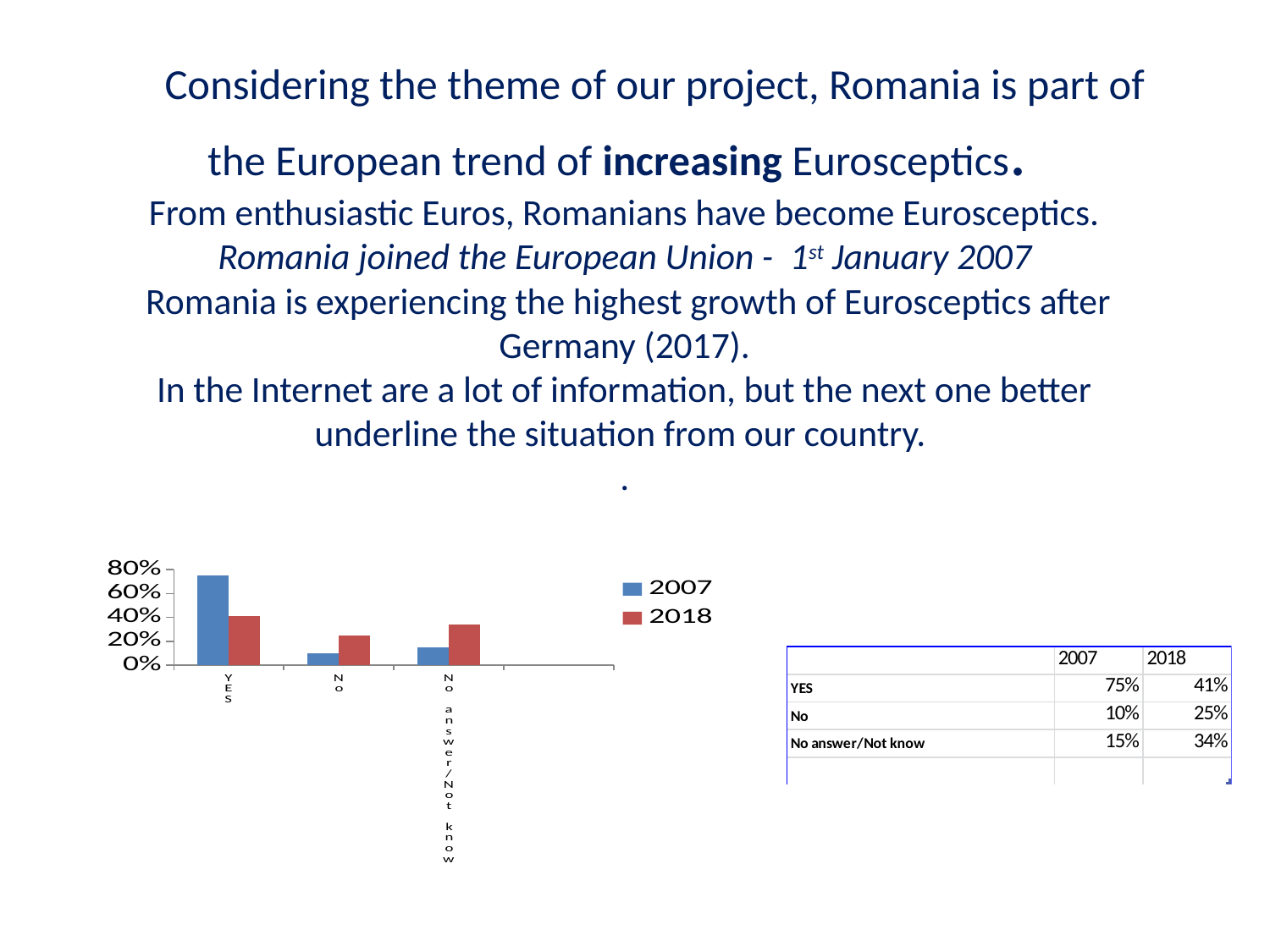
According to the table beside the chart, what is the value for No answer/Not know in 2018? 34% How many categories are shown on the x axis of the chart? 3 Using the values in the table, what is the difference between the 2007 and 2018 values for YES? 34% Which is larger for the No category: the 2007 value or the 2018 value? 2018 Is the 2007 value for YES greater or less than 60%? greater Which years are listed in the chart legend? 2007 and 2018 Which category has the lowest value for the 2007 series? No Which category has the highest value for the 2007 series? YES What kind of chart is shown on the slide? bar chart According to the table beside the chart, what is the value for YES in 2007? 75% According to the table beside the chart, what is the value for YES in 2018? 41% How many series does the chart legend list? 2